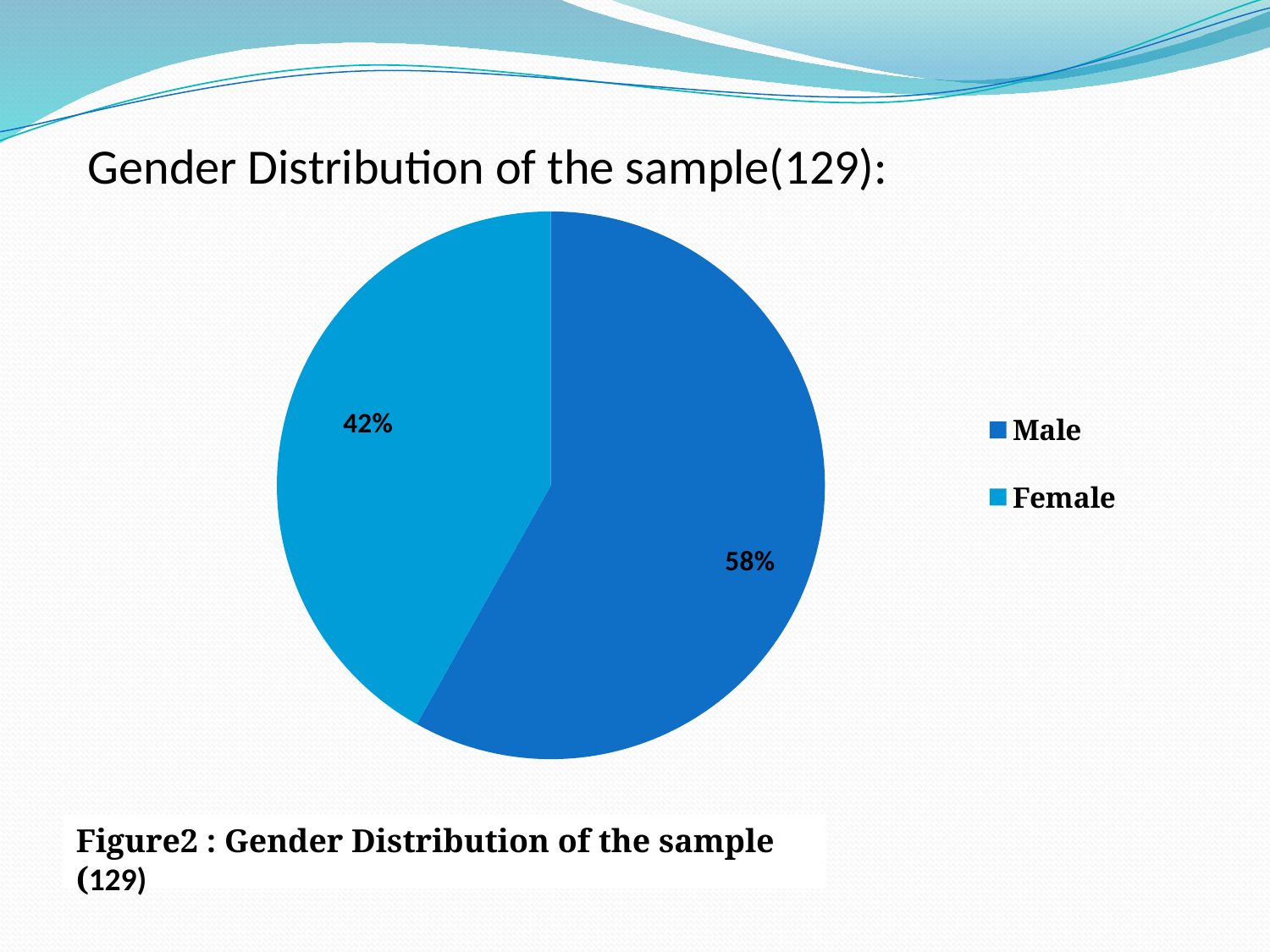
What is the title of the chart? Gender Distribution of the sample(129) Which gender has the smallest share of the sample? Female What is the total sample size stated in the chart title? 129 Which is larger, the Male share or the Female share? Male How many entries does the legend list? 2 Which gender has the largest share of the sample? Male Which legend entry is shown in the lighter blue colour? Female What share of the sample is Male? 58% What is the difference in percentage points between the Male and Female shares? 16 How many slices does the pie chart have? 2 What share of the sample is Female? 42% What kind of chart is shown on the slide? pie chart